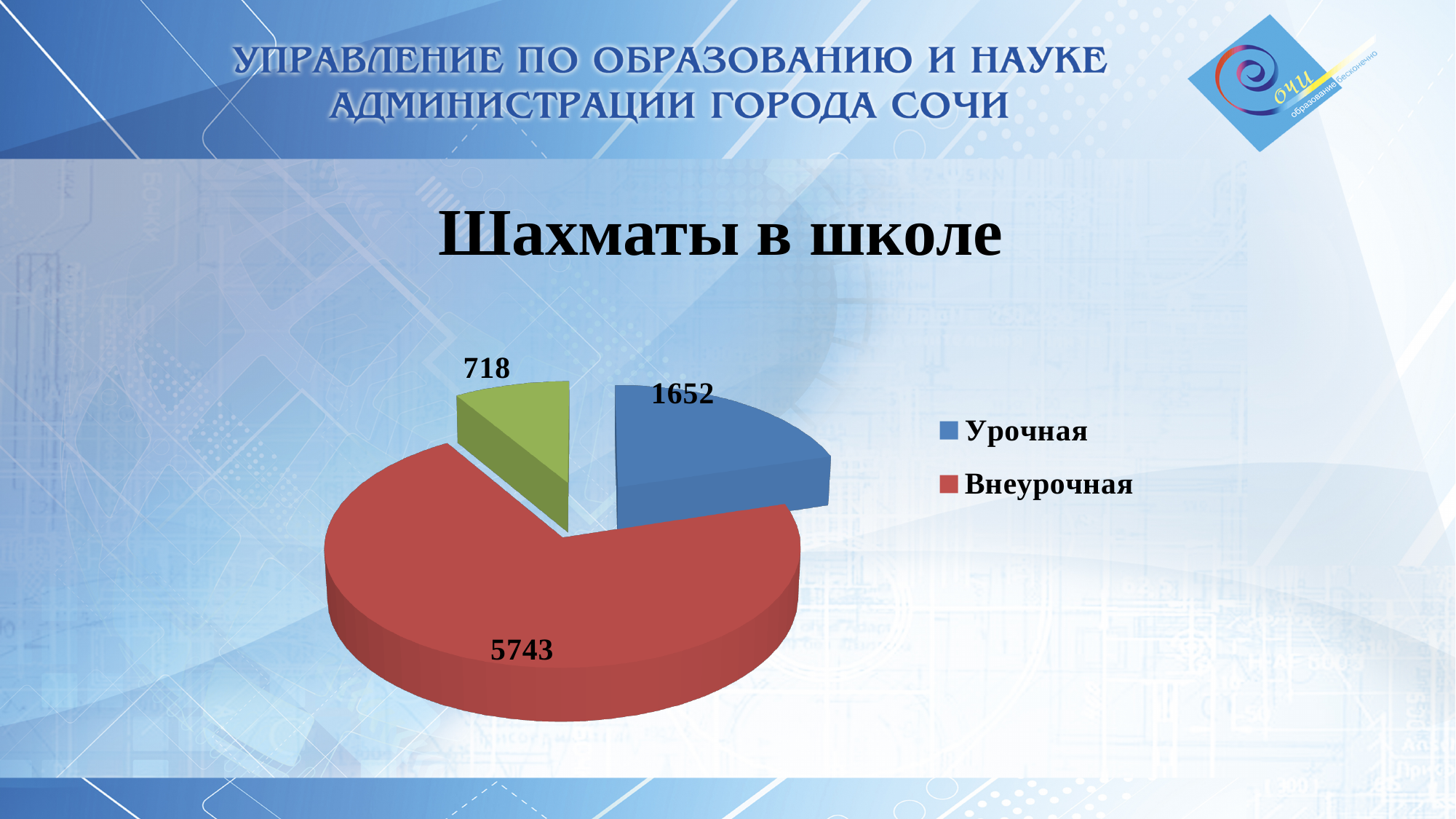
What is the total of all the values shown on the pie chart? 8113 What type of chart is shown on the slide? pie chart What is the difference between the values for Внеурочная and Урочная? 4091 What is the title of the chart? Шахматы в школе How many entries does the legend list? 2 Which category has the largest slice of the pie? Внеурочная What colour is the slice for Внеурочная? red What is the smallest value shown on the pie chart? 718 What is the value for Внеурочная? 5743 Which is larger, the value for Урочная or the value for Внеурочная? Внеурочная What is the value for Урочная? 1652 How many slices does the pie chart have? 3